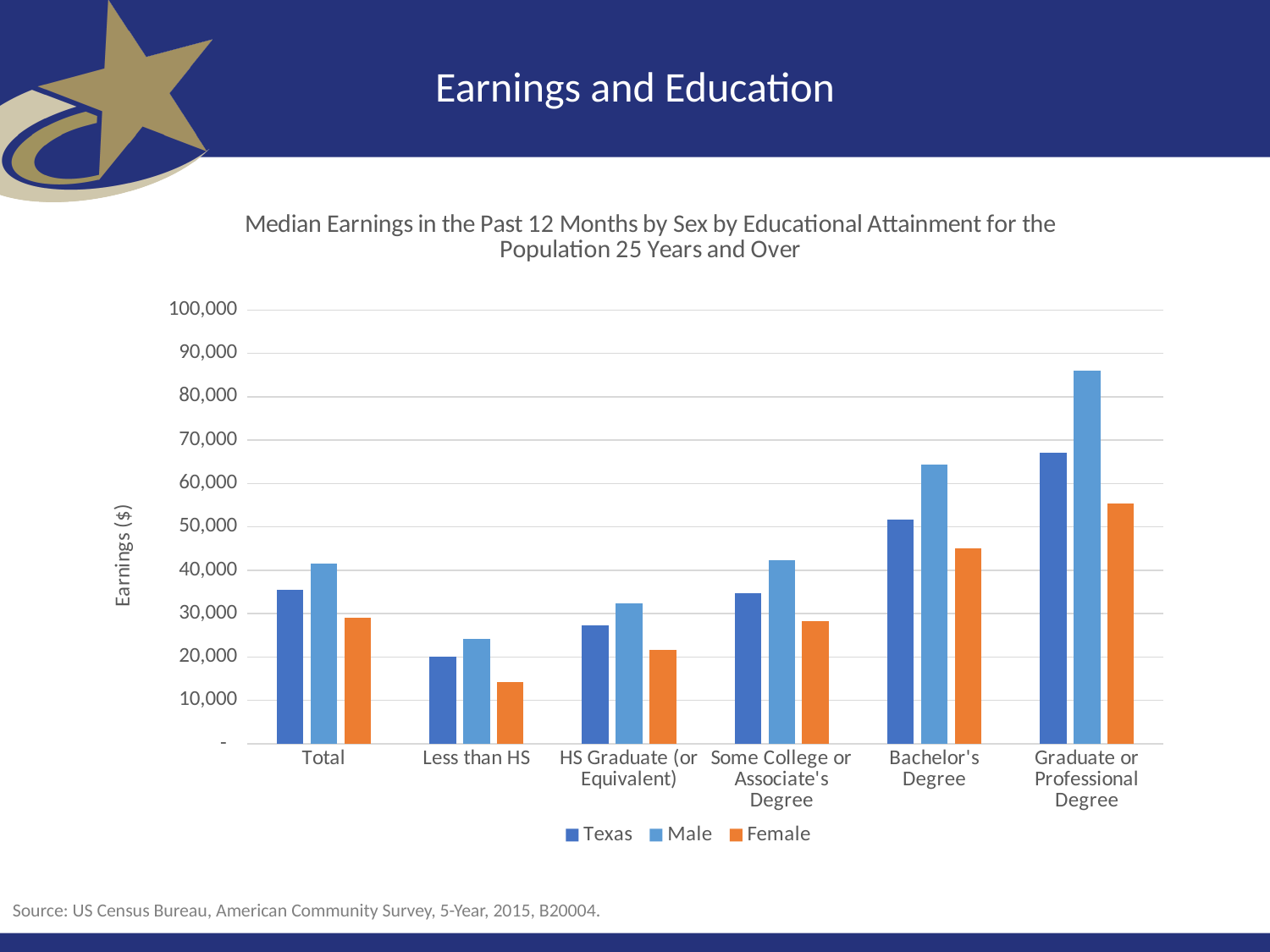
Which category has the highest Male median earnings? Graduate or Professional Degree Do the Texas values rise or fall moving from Less than HS to Graduate or Professional Degree along the x axis? rise Is the Female value for Less than HS greater or less than 20,000? less What kind of chart is shown on the slide? bar chart Is the Male value for Graduate or Professional Degree greater or less than 80,000? greater For Bachelor's Degree, which is larger, the Male value or the Female value? Male How many educational attainment categories are shown on the x axis? 6 How many series does the legend list? 3 Is the Texas value for Graduate or Professional Degree greater or less than 60,000? greater Which is larger, the Female value for Total or the Female value for HS Graduate (or Equivalent)? Total What is the label on the vertical axis? Earnings ($) Which category has the lowest Female median earnings? Less than HS